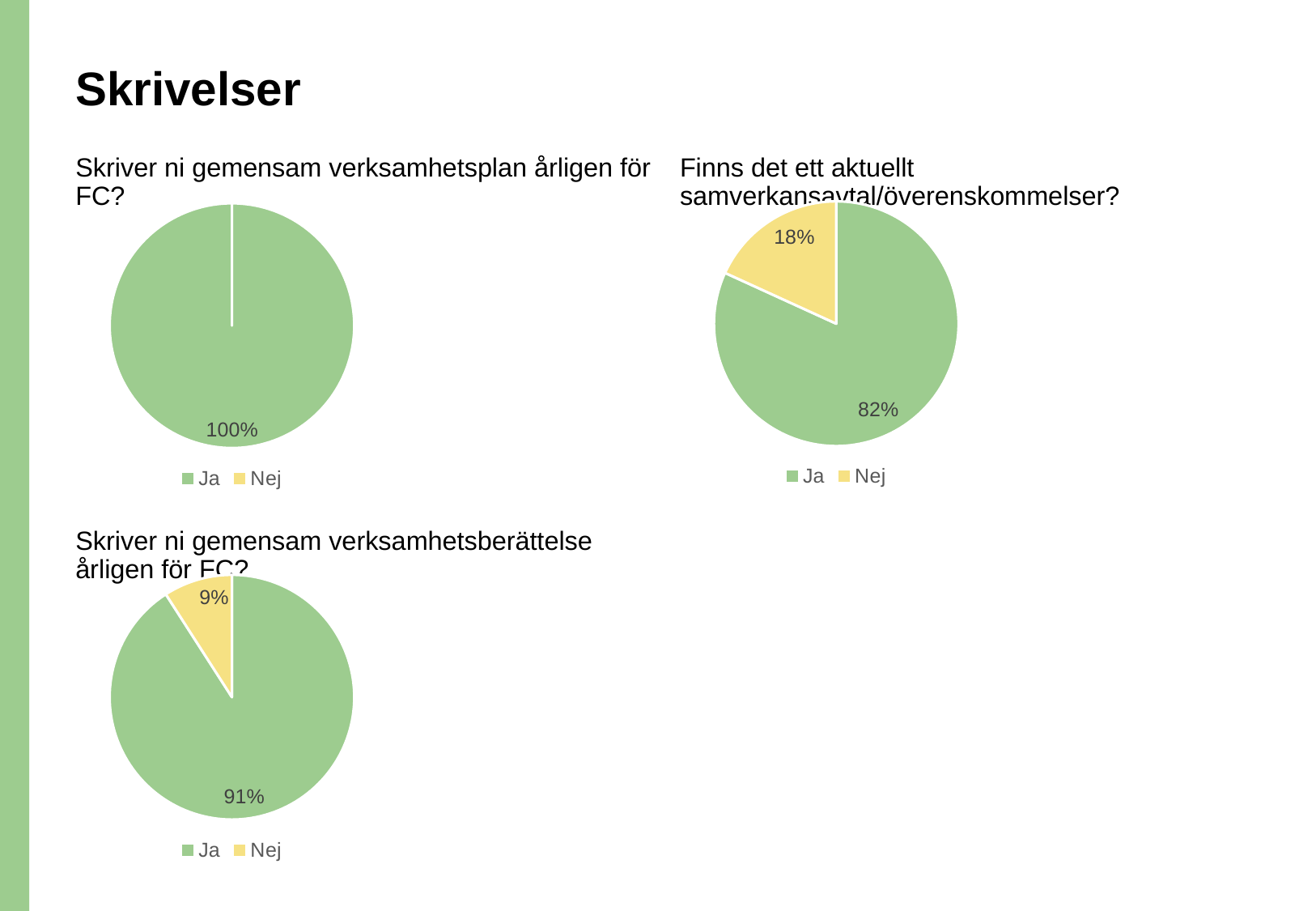
In the bottom-left pie chart ("Skriver ni gemensam verksamhetsberättelse årligen för FC?"), what share is labelled for Nej? 9% In the bottom-left pie chart ("Skriver ni gemensam verksamhetsberättelse årligen för FC?"), which category has the smallest slice? Nej What kind of chart is the top-left chart ("Skriver ni gemensam verksamhetsplan årligen för FC?")? Pie chart In the top-right pie chart ("Finns det ett aktuellt samverkansavtal/överenskommelser?"), which category has the largest slice? Ja In the top-right pie chart ("Finns det ett aktuellt samverkansavtal/överenskommelser?"), what share is labelled for Nej? 18% In the bottom-left pie chart ("Skriver ni gemensam verksamhetsberättelse årligen för FC?"), what share is labelled for Ja? 91% In the bottom-left pie chart ("Skriver ni gemensam verksamhetsberättelse årligen för FC?"), which is larger, Ja or Nej? Ja In the top-left pie chart ("Skriver ni gemensam verksamhetsplan årligen för FC?"), what share is labelled for Ja? 100% In the top-right pie chart ("Finns det ett aktuellt samverkansavtal/överenskommelser?"), what share is labelled for Ja? 82% How many entries does the legend of the top-right pie chart ("Finns det ett aktuellt samverkansavtal/överenskommelser?") list? 2 In the bottom-left pie chart ("Skriver ni gemensam verksamhetsberättelse årligen för FC?"), what colour is the Nej slice? Yellow In the top-right pie chart ("Finns det ett aktuellt samverkansavtal/överenskommelser?"), what is the difference in percentage points between Ja and Nej? 64